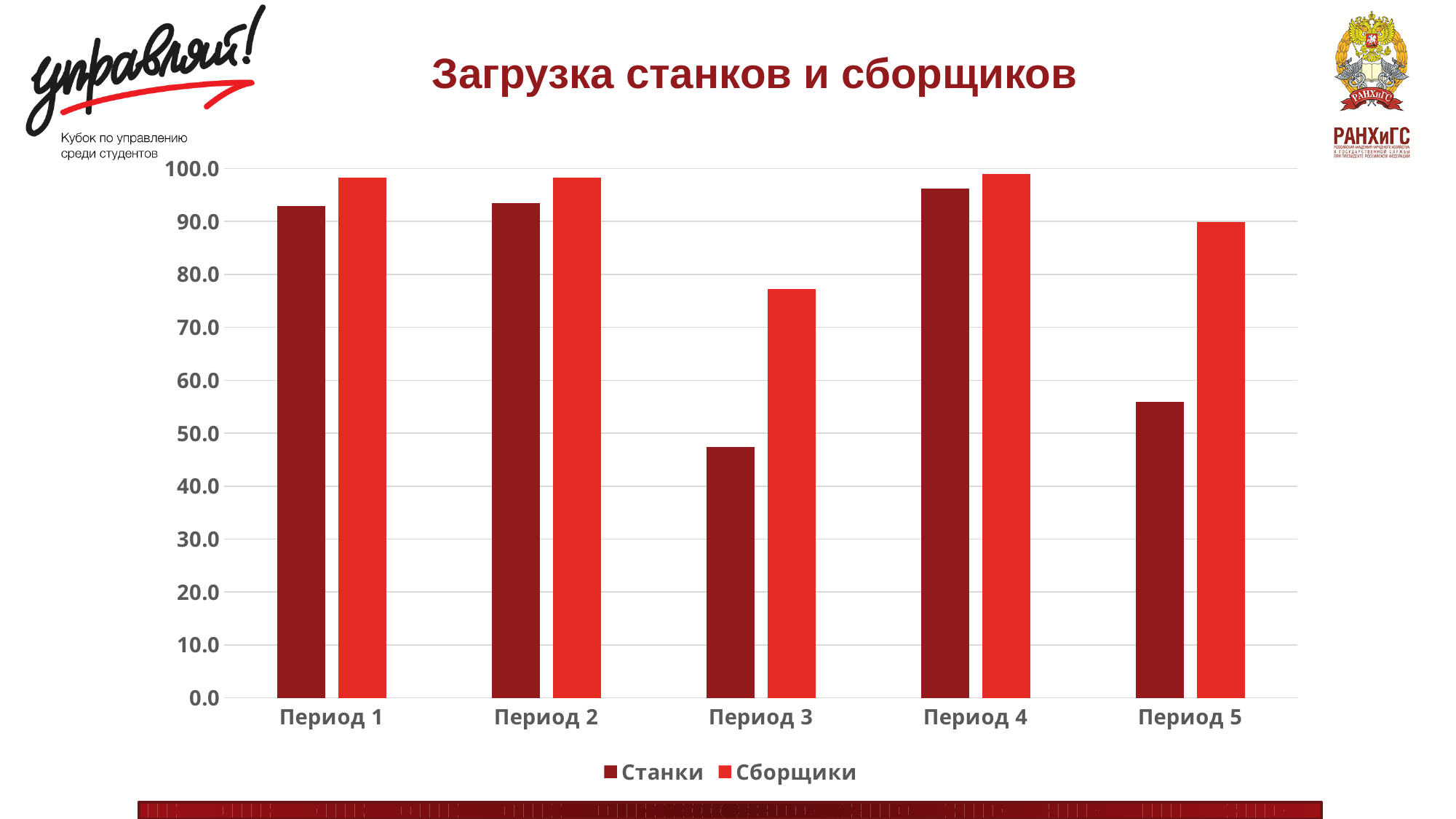
In Период 5, which is larger: Станки or Сборщики? Сборщики In which period is the value for Станки the lowest? Период 3 How many series does the legend list? 2 Is the value for Станки in Период 1 greater or less than 90? greater In which period is the value for Сборщики the lowest? Период 3 How many periods (categories) are shown on the x axis? 5 What is the title of the chart? Загрузка станков и сборщиков Is the value for Станки in Период 3 greater or less than 50? less Is the value for Сборщики in Период 3 greater or less than 80? less In which period is the value for Станки the highest? Период 4 What kind of chart is shown on the slide? bar chart Which series is shown in dark red in the legend? Станки